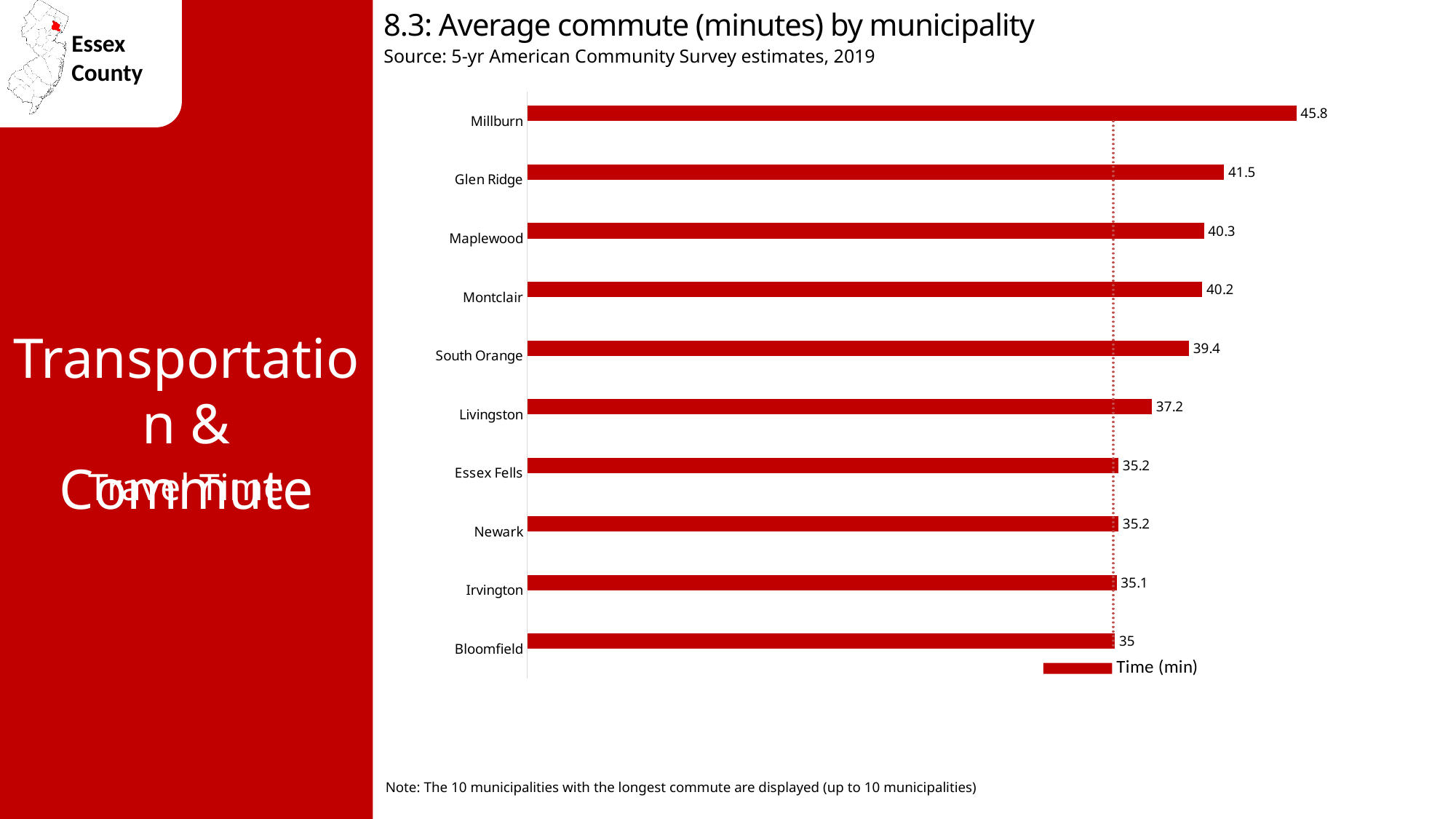
What kind of chart is shown on the slide? Bar chart How many series does the legend list? 1 Which has a longer average commute, Maplewood or Livingston? Maplewood What is the difference in average commute time between Livingston and Irvington? 2.1 What is the average commute time for South Orange? 39.4 What is the difference in average commute time between Millburn and Glen Ridge? 4.3 Which municipality has the shortest average commute among those shown? Bloomfield What is the average commute time for Millburn? 45.8 How many municipalities are shown in the chart? 10 What is the average commute time for Bloomfield? 35 What is the legend entry for the series in the chart? Time (min) Which municipality has the longest average commute? Millburn